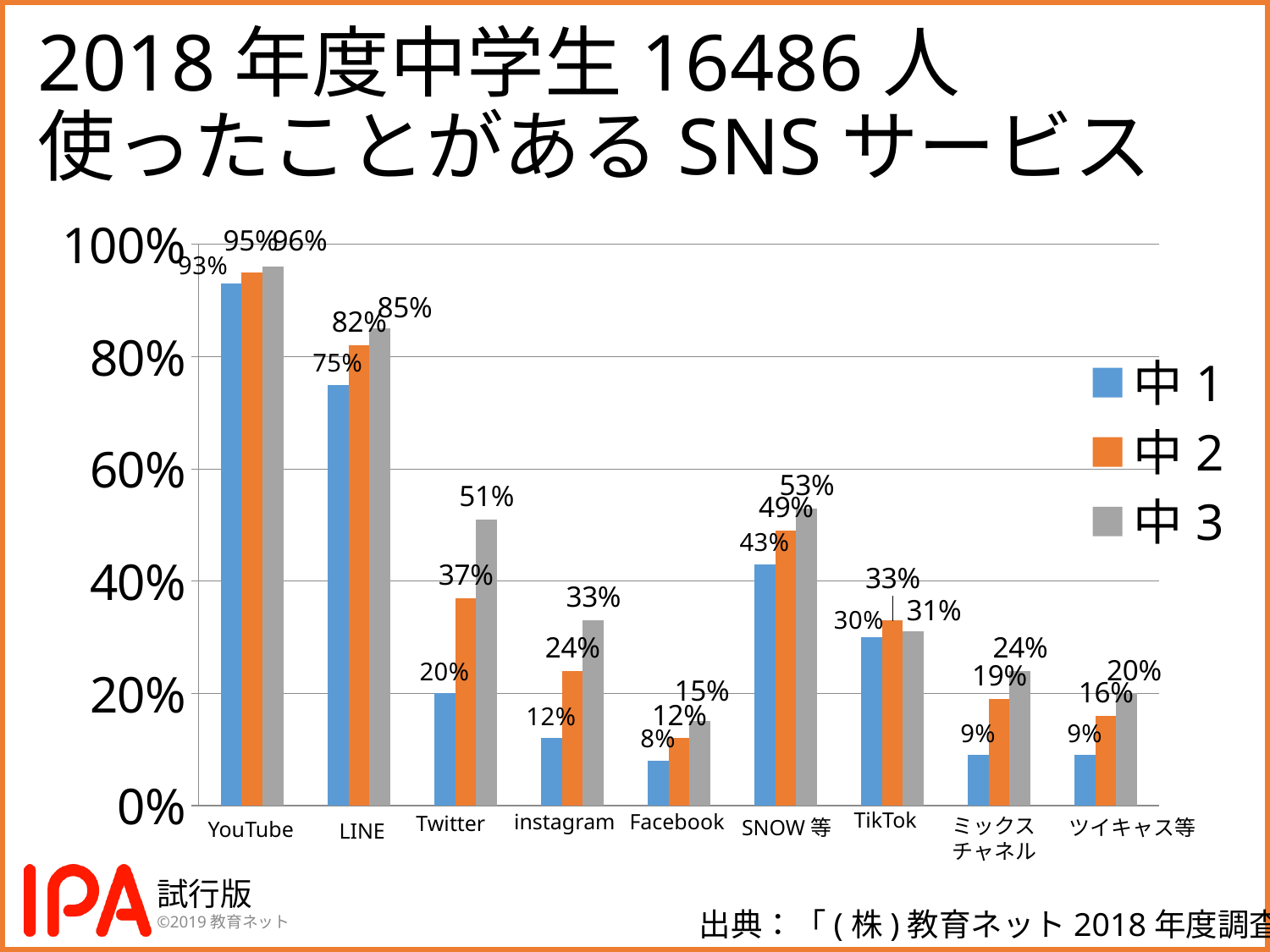
What is the difference between the 中3 and 中1 values for Twitter? 31% What kind of chart is shown on the slide? bar chart Is the value for 中1 for SNOW等 greater or less than 40%? greater What is the value for 中2 for SNOW等? 49% Which category has the highest value for 中3? YouTube Which category has the lowest value for 中2? Facebook Which is larger for instagram, the 中2 value or the 中3 value? 中3 What is the value for 中1 for LINE? 75% What is the value for 中3 for Twitter? 51% How many categories are shown on the x axis? 9 What is the value for 中1 for Facebook? 8% How many series does the legend list? 3